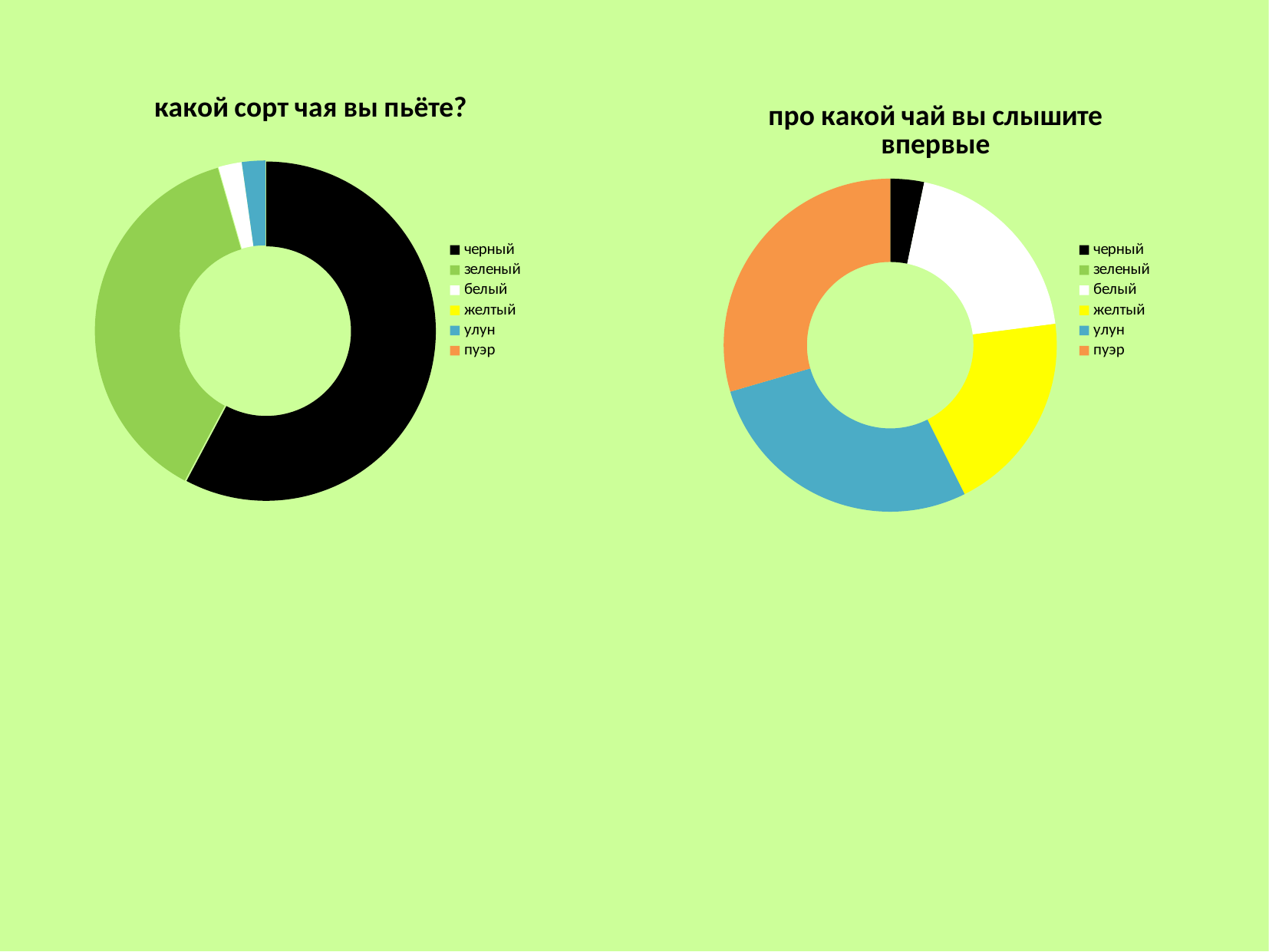
In the chart "какой сорт чая вы пьёте?", which is larger, черный or зеленый? черный In the legend of the chart "про какой чай вы слышите впервые", which colour represents пуэр? orange In the chart "про какой чай вы слышите впервые", which is larger, улун or желтый? улун In the chart "про какой чай вы слышите впервые", which is larger, пуэр or черный? пуэр How many categories does the legend of the chart "какой сорт чая вы пьёте?" list? 6 What is the title of the chart on the right side of the slide? про какой чай вы слышите впервые What kind of chart is the chart titled "про какой чай вы слышите впервые"? pie chart (doughnut) In the chart "какой сорт чая вы пьёте?", which category has the largest slice? черный What kind of chart is the chart titled "какой сорт чая вы пьёте?"? pie chart (doughnut) In the chart "про какой чай вы слышите впервые", which visible category has the smallest slice? черный